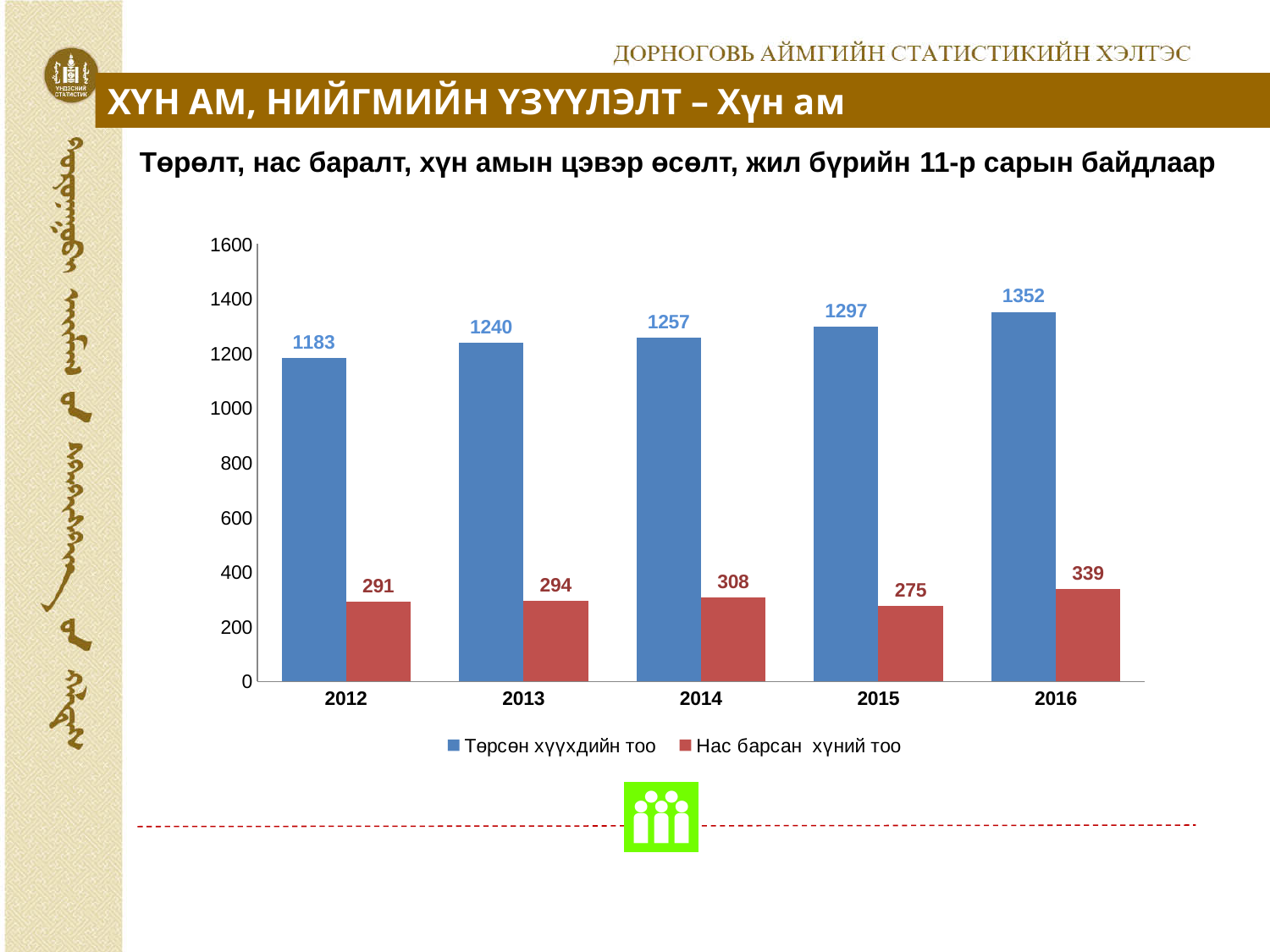
What is the value for Төрсөн хүүхдийн тоо in 2014? 1257 Is the value for Төрсөн хүүхдийн тоо in 2012 greater or less than 1000? greater What colour are the bars for Нас барсан хүний тоо? red Does Төрсөн хүүхдийн тоо rise or fall from 2012 to 2016? rise Which is larger: Нас барсан хүний тоо in 2013 or in 2014? 2014 What is the difference between Төрсөн хүүхдийн тоо and Нас барсан хүний тоо in 2016? 1013 Which year has the highest value for Төрсөн хүүхдийн тоо? 2016 How many series does the legend list? 2 What is the value for Нас барсан хүний тоо in 2015? 275 What kind of chart is shown on the slide? bar chart How many years are shown on the x axis? 5 Which year has the lowest value for Нас барсан хүний тоо? 2015